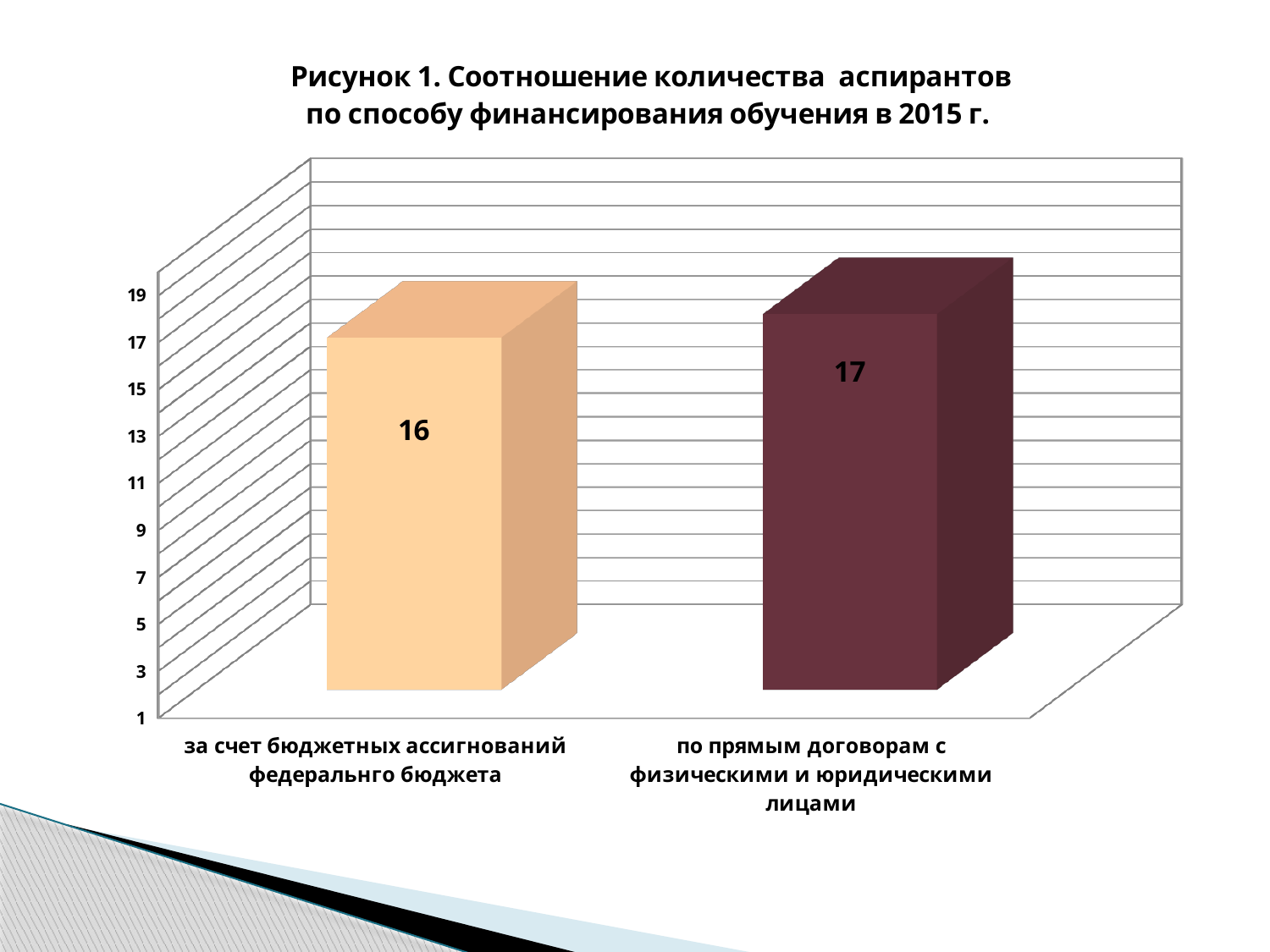
What is the difference between the values for 'по прямым договорам с физическими и юридическими лицами' and 'за счет бюджетных ассигнований федеральнго бюджета'? 1 Is the value for 'за счет бюджетных ассигнований федеральнго бюджета' greater or less than 11? greater What is the title of the chart? Рисунок 1. Соотношение количества аспирантов по способу финансирования обучения в 2015 г. Which category has the lowest value? за счет бюджетных ассигнований федеральнго бюджета What is the total of the two values shown in the chart? 33 What is the value for 'за счет бюджетных ассигнований федеральнго бюджета'? 16 What is the value for 'по прямым договорам с физическими и юридическими лицами'? 17 What colour is the bar for 'по прямым договорам с физическими и юридическими лицами'? dark purple Which is larger: the value for 'за счет бюджетных ассигнований федеральнго бюджета' or the value for 'по прямым договорам с физическими и юридическими лицами'? по прямым договорам с физическими и юридическими лицами What kind of chart is shown on the slide? bar chart Which category has the highest value? по прямым договорам с физическими и юридическими лицами How many categories are shown in the chart? 2